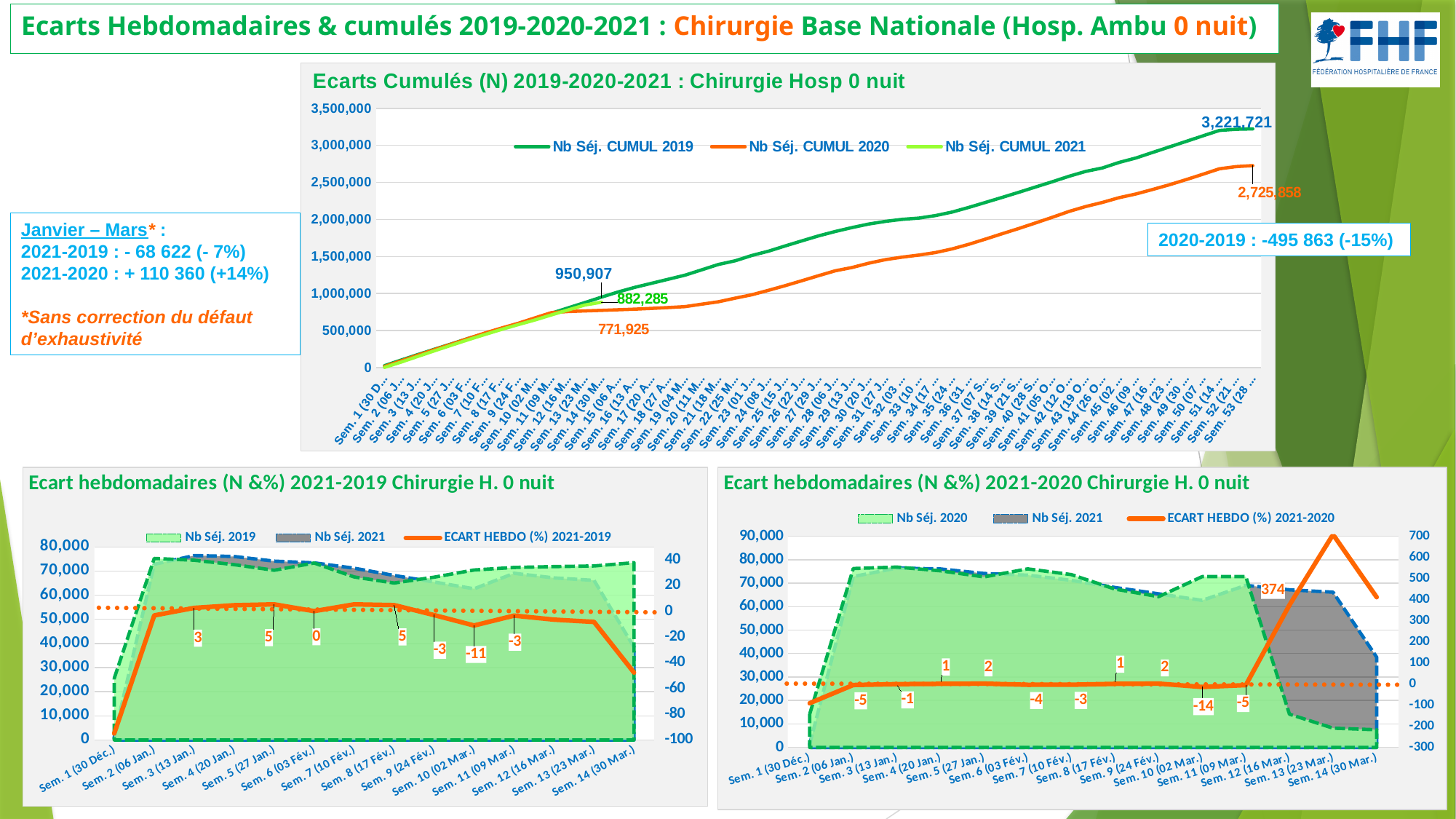
In the top chart 'Ecarts Cumulés (N) 2019-2020-2021', what is the final labelled value of Nb Séj. CUMUL 2019? 3,221,721 In the top chart 'Ecarts Cumulés (N) 2019-2020-2021', what is the final labelled value of Nb Séj. CUMUL 2020? 2,725,858 In the top chart 'Ecarts Cumulés (N) 2019-2020-2021', how many series does the legend list? 3 In the top chart 'Ecarts Cumulés (N) 2019-2020-2021', what is the difference between the final labelled values of Nb Séj. CUMUL 2019 and Nb Séj. CUMUL 2020? 495,863 In the bottom-left chart 'Ecart hebdomadaires (N &%) 2021-2019', how many weeks are shown on the x axis? 14 In the bottom-right chart 'Ecart hebdomadaires (N &%) 2021-2020', what is the highest labelled value of ECART HEBDO (%) 2021-2020? 374 In the top chart 'Ecarts Cumulés (N) 2019-2020-2021', does the Nb Séj. CUMUL 2019 line rise or fall along the x axis? Rises In the top chart 'Ecarts Cumulés (N) 2019-2020-2021', which series ends at the highest value? Nb Séj. CUMUL 2019 In the bottom-right chart 'Ecart hebdomadaires (N &%) 2021-2020', how many series does the legend list? 3 What kind of chart is the top chart 'Ecarts Cumulés (N) 2019-2020-2021'? Line chart In the bottom-left chart 'Ecart hebdomadaires (N &%) 2021-2019', what is the lowest labelled value of ECART HEBDO (%) 2021-2019? -11 In the top chart 'Ecarts Cumulés (N) 2019-2020-2021', what is the labelled value shown for Nb Séj. CUMUL 2021? 882,285